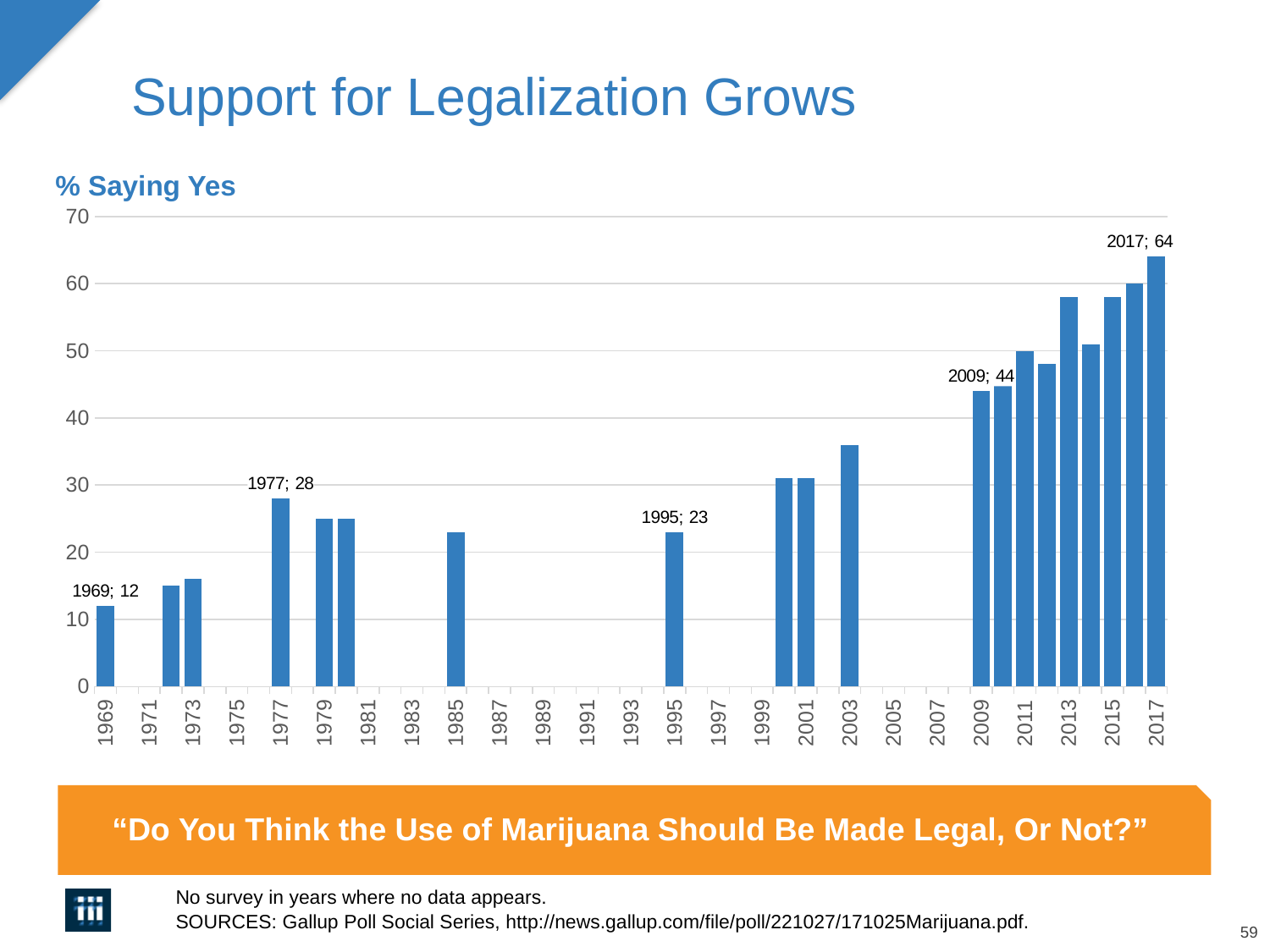
What is the value for 1995? 23 Is the value for 2003 greater or less than 30? greater Which is larger, the value for 1977 or the value for 1995? 1977 What is the value for 2017? 64 What is the value for 2009? 44 Do the values generally rise or fall from 1969 to 2017? rise What is the difference between the values for 2017 and 1969? 52 What kind of chart is shown on the slide? bar chart Which year has the highest value? 2017 Which year has the lowest value? 1969 What is the value for 1969? 12 What is the value for 1977? 28